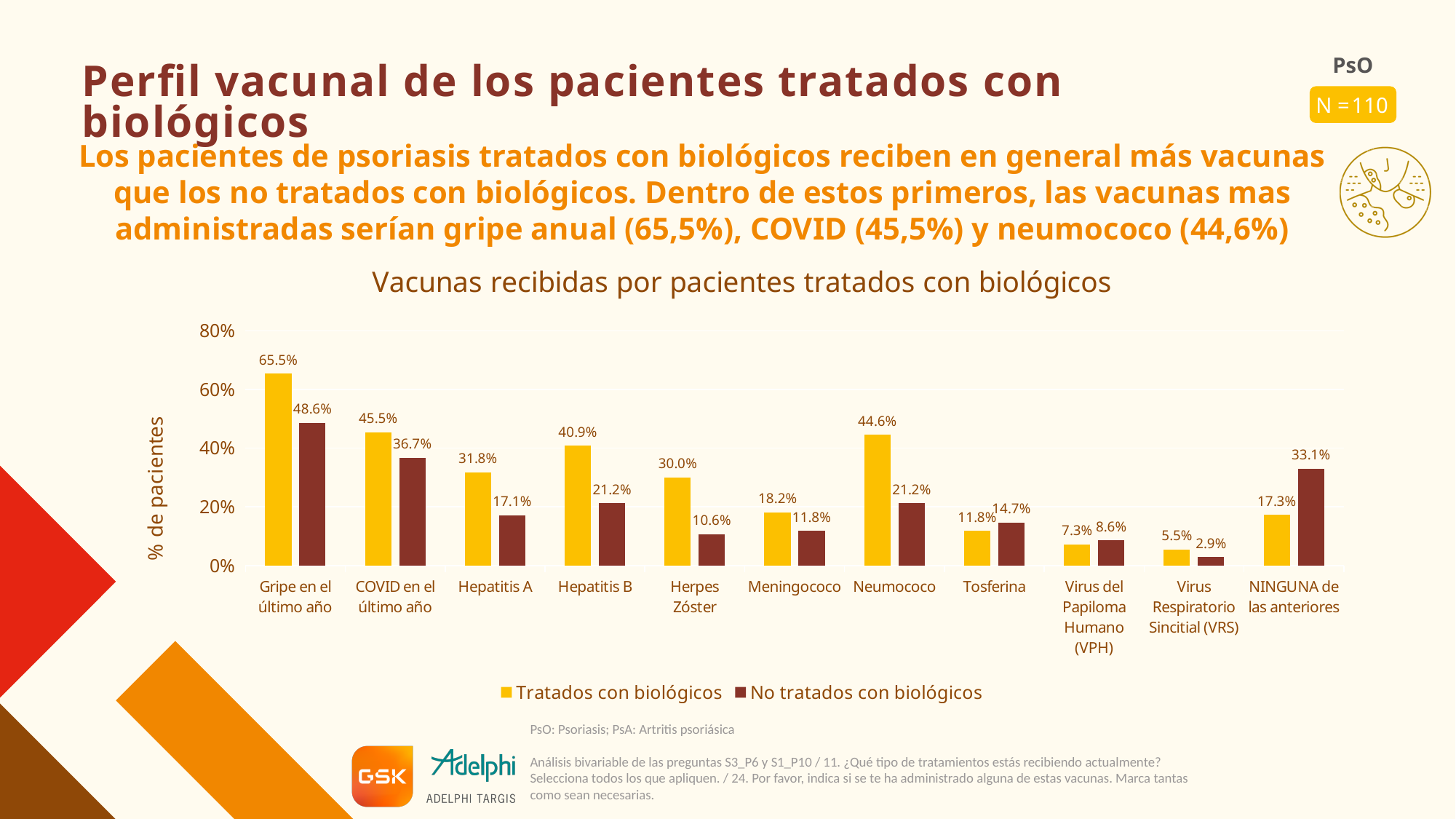
What is the title of the chart? Vacunas recibidas por pacientes tratados con biológicos What kind of chart is shown on the slide? Bar chart What is the value for Neumococo in the No tratados con biológicos series? 21.2% What is the value for Hepatitis B in the Tratados con biológicos series? 40.9% What is the difference between the Tratados con biológicos and No tratados con biológicos values for Hepatitis A? 14.7% What is the value for Herpes Zóster in the Tratados con biológicos series? 30.0% How many vaccine categories are shown on the x axis? 11 For NINGUNA de las anteriores, which series has the larger value: Tratados con biológicos or No tratados con biológicos? No tratados con biológicos Which category has the lowest value in the No tratados con biológicos series? Virus Respiratorio Sincitial (VRS) How many series does the legend list? 2 Is the value for COVID en el último año in the Tratados con biológicos series greater or less than 40%? greater Which category has the highest value in the Tratados con biológicos series? Gripe en el último año